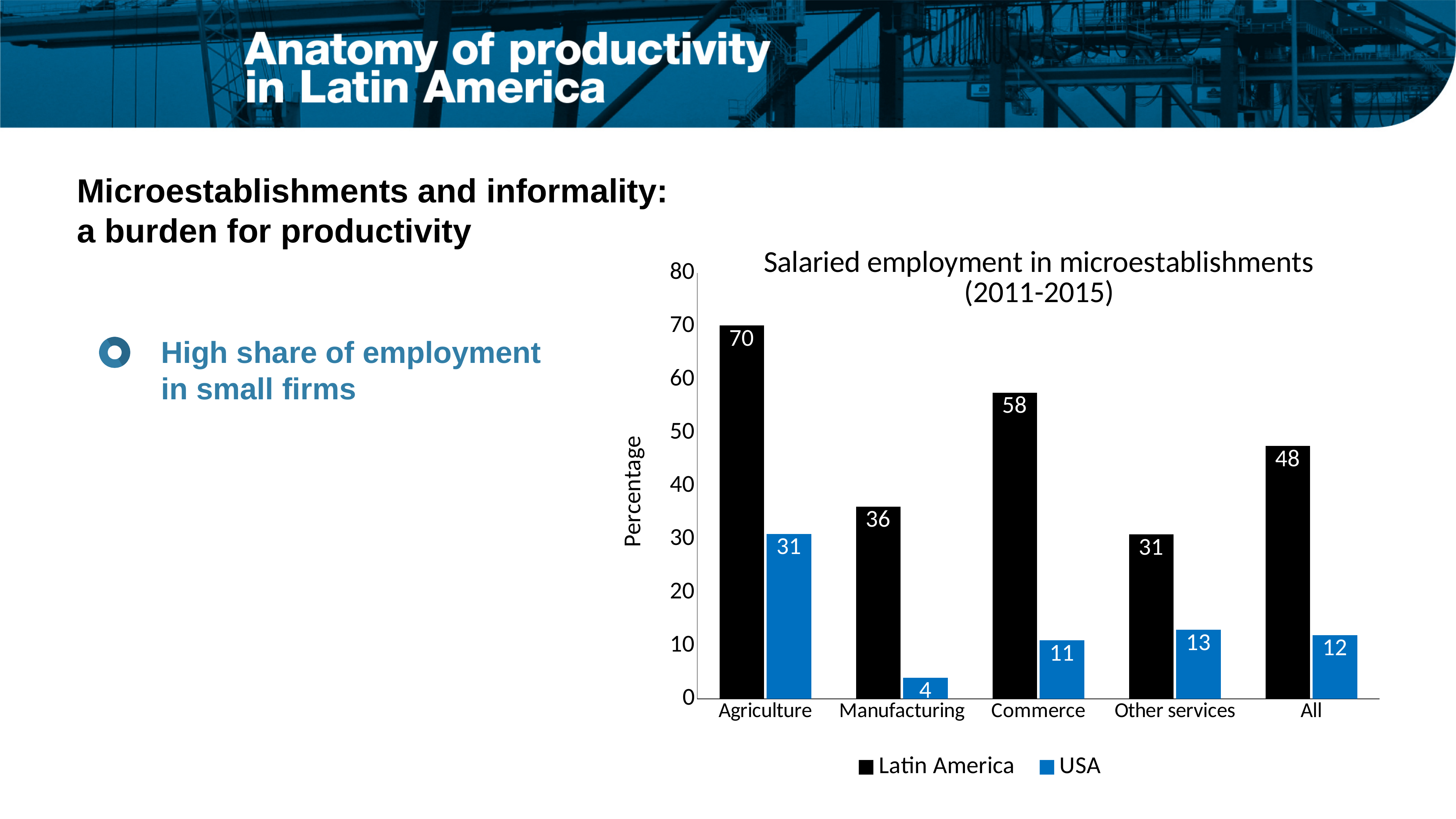
What is the value for Latin America in the All category? 48 How many series does the legend list? 2 What is the value for USA in Manufacturing? 4 What kind of chart is shown on the slide? Bar chart Which is larger: the USA value for Other services or the USA value for All? Other services Which category has the highest value for Latin America? Agriculture How many categories are shown on the x axis? 5 What is the value for Latin America in Agriculture? 70 Which category has the lowest value for USA? Manufacturing What is the label of the y axis? Percentage What is the title of the chart? Salaried employment in microestablishments (2011-2015) What is the difference between the Latin America and USA values in Commerce? 47